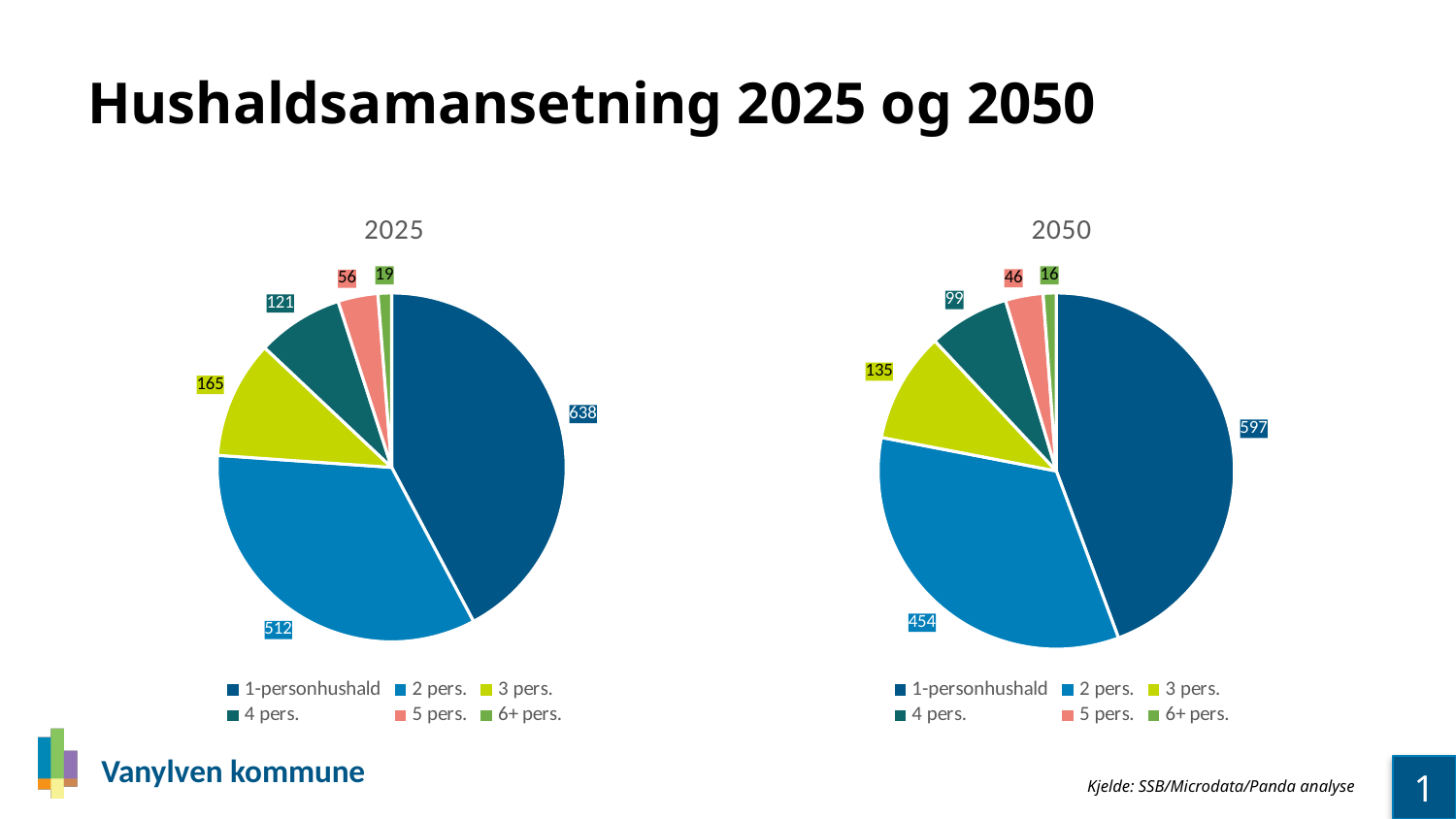
How many categories does the 2050 pie chart show? 6 Which is larger: the 2 pers. value in the 2025 chart or the 2 pers. value in the 2050 chart? 2025 What type of chart is used for the 2025 data? Pie chart What is the title of the slide? Hushaldsamansetning 2025 og 2050 What is the difference between the 1-personhushald value in the 2025 chart and the 1-personhushald value in the 2050 chart? 41 In the 2050 pie chart, what is the value for 2 pers.? 454 In the 2025 pie chart, what is the value for 4 pers.? 121 In the 2025 pie chart, what is the value for 1-personhushald? 638 In the 2050 pie chart, which category has the largest value? 1-personhushald In the 2050 pie chart, what is the value for 6+ pers.? 16 In the 2025 pie chart, what is the difference between the values for 3 pers. and 4 pers.? 44 In the 2025 pie chart, which category has the smallest value? 6+ pers.